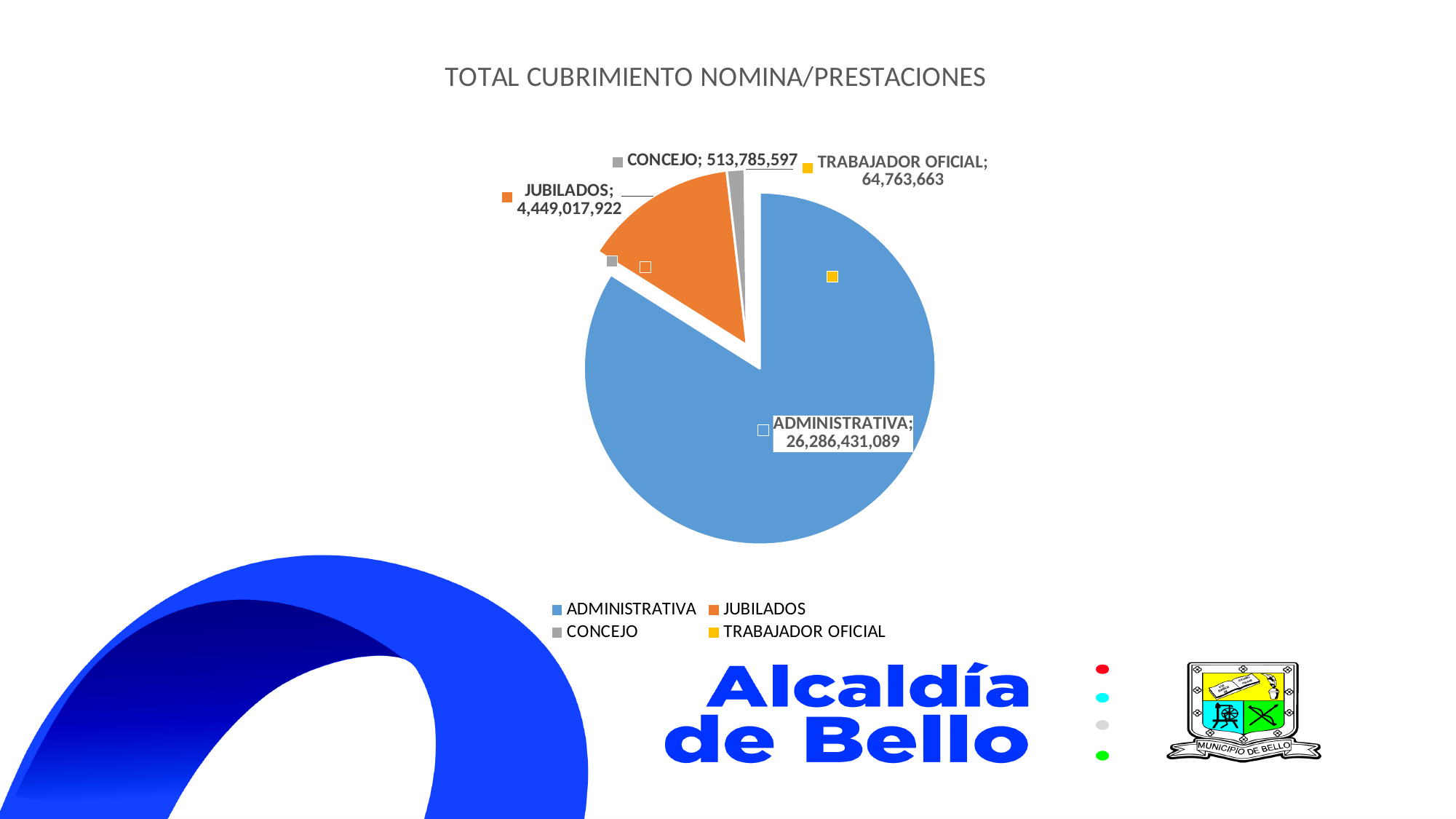
What is the difference between the values for ADMINISTRATIVA and JUBILADOS? 21,837,413,167 Which is larger, the value for JUBILADOS or the value for CONCEJO? JUBILADOS What kind of chart is shown on the slide? Pie chart Which category has the smallest slice in the pie chart? TRABAJADOR OFICIAL What is the value for ADMINISTRATIVA in the pie chart? 26,286,431,089 What is the value for CONCEJO in the pie chart? 513,785,597 What is the difference between the values for CONCEJO and TRABAJADOR OFICIAL? 449,021,934 What is the value for JUBILADOS in the pie chart? 4,449,017,922 Which category has the largest slice in the pie chart? ADMINISTRATIVA How many categories are shown in the pie chart? 4 What is the title of the chart? TOTAL CUBRIMIENTO NOMINA/PRESTACIONES What is the value for TRABAJADOR OFICIAL in the pie chart? 64,763,663